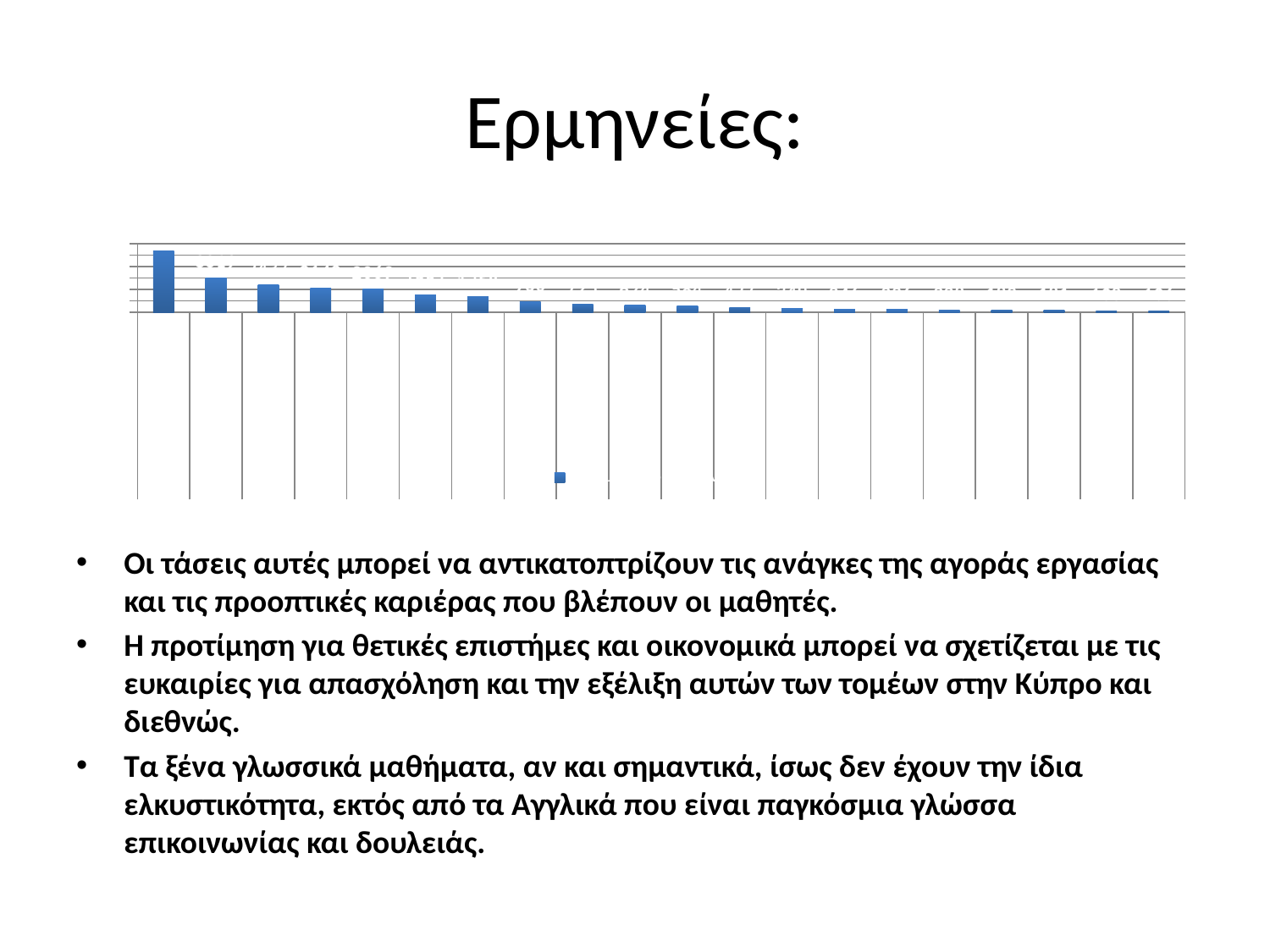
What colour are the bars in the chart? blue Which bar is the tallest in the chart, the leftmost or the rightmost? the leftmost How many bars are plotted in the chart? 20 What kind of chart is shown on the slide? bar chart Do the bar values rise or fall from left to right along the x axis? fall